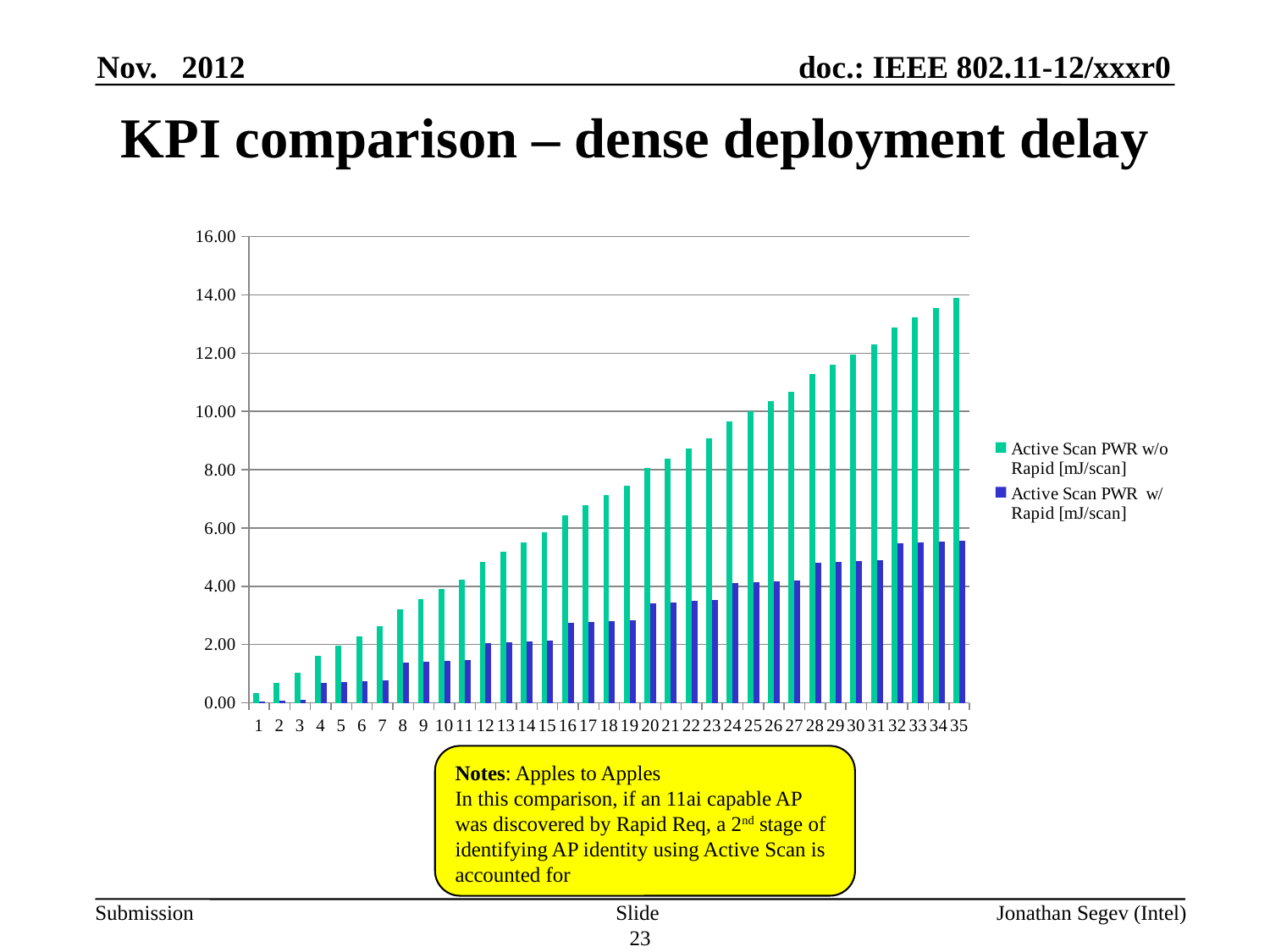
How many categories are shown along the x axis? 35 How many series does the legend list? 2 What are the two series named in the legend? Active Scan PWR w/o Rapid [mJ/scan] and Active Scan PWR w/ Rapid [mJ/scan] At which category is the value for Active Scan PWR w/o Rapid [mJ/scan] highest? 35 What kind of chart is shown on the slide? bar chart Is the value for Active Scan PWR w/o Rapid [mJ/scan] at category 28 greater or less than 10.00? greater Is the value for Active Scan PWR w/o Rapid [mJ/scan] at category 35 greater or less than 12.00? greater Do the values for Active Scan PWR w/o Rapid [mJ/scan] rise or fall as the category number increases? rise Is the value for Active Scan PWR w/ Rapid [mJ/scan] at category 20 greater or less than 4.00? less At which category is the value for Active Scan PWR w/o Rapid [mJ/scan] lowest? 1 At category 35, which series has the larger value: Active Scan PWR w/o Rapid or Active Scan PWR w/ Rapid? Active Scan PWR w/o Rapid [mJ/scan] Which series is drawn in green? Active Scan PWR w/o Rapid [mJ/scan]